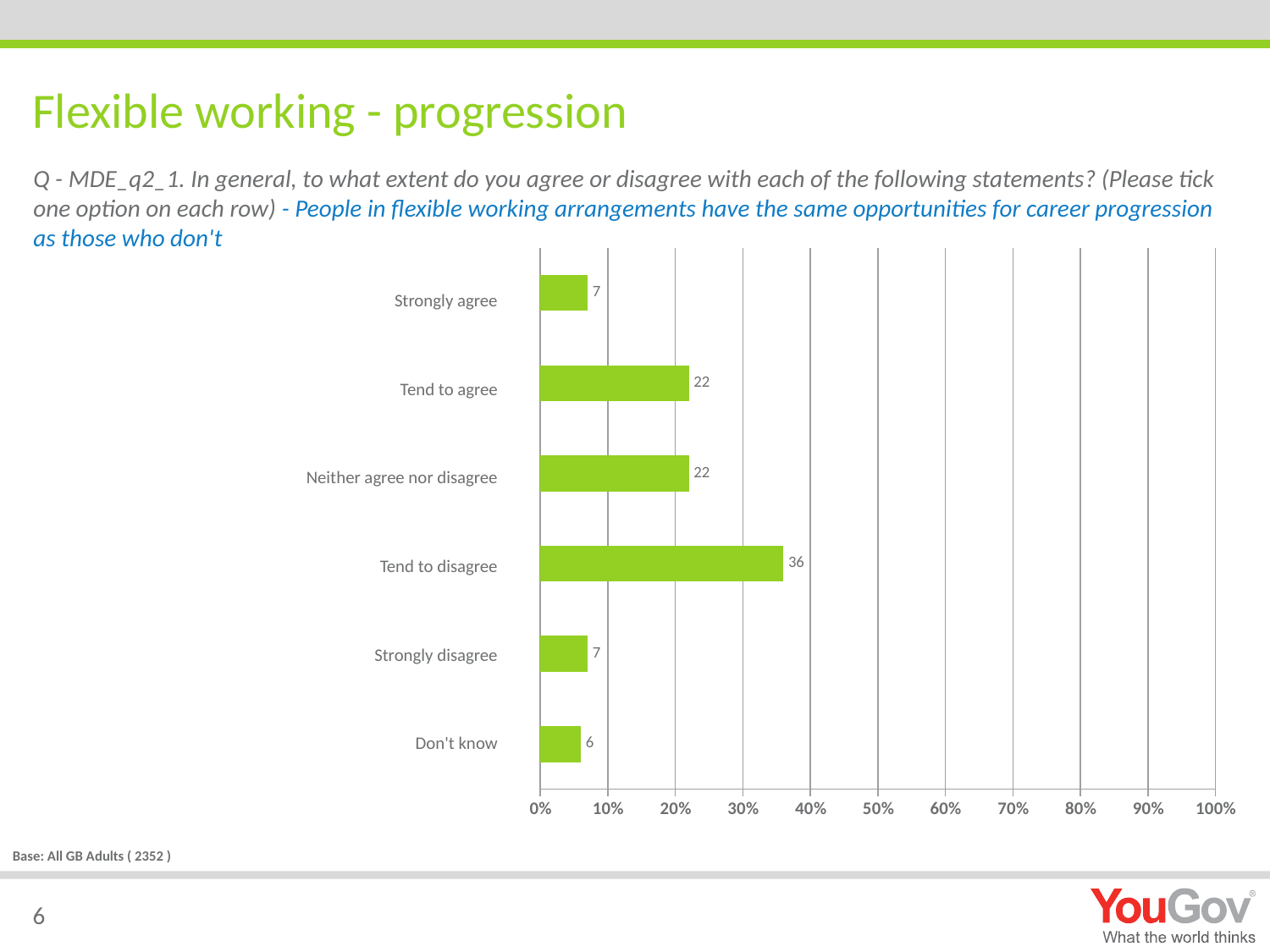
What is the value for Tend to disagree? 36 What is the difference between the values for Tend to disagree and Tend to agree? 14 Which is larger, the value for Tend to agree or the value for Strongly disagree? Tend to agree What is the value for Strongly agree? 7 What kind of chart is shown on the slide? Bar chart What is the title of the slide? Flexible working - progression Which category has the lowest value? Don't know How many categories are shown in the chart? 6 Is the value for Tend to disagree greater or less than 30%? greater Which category has the highest value? Tend to disagree What is the value for Neither agree nor disagree? 22 What is the value for Don't know? 6